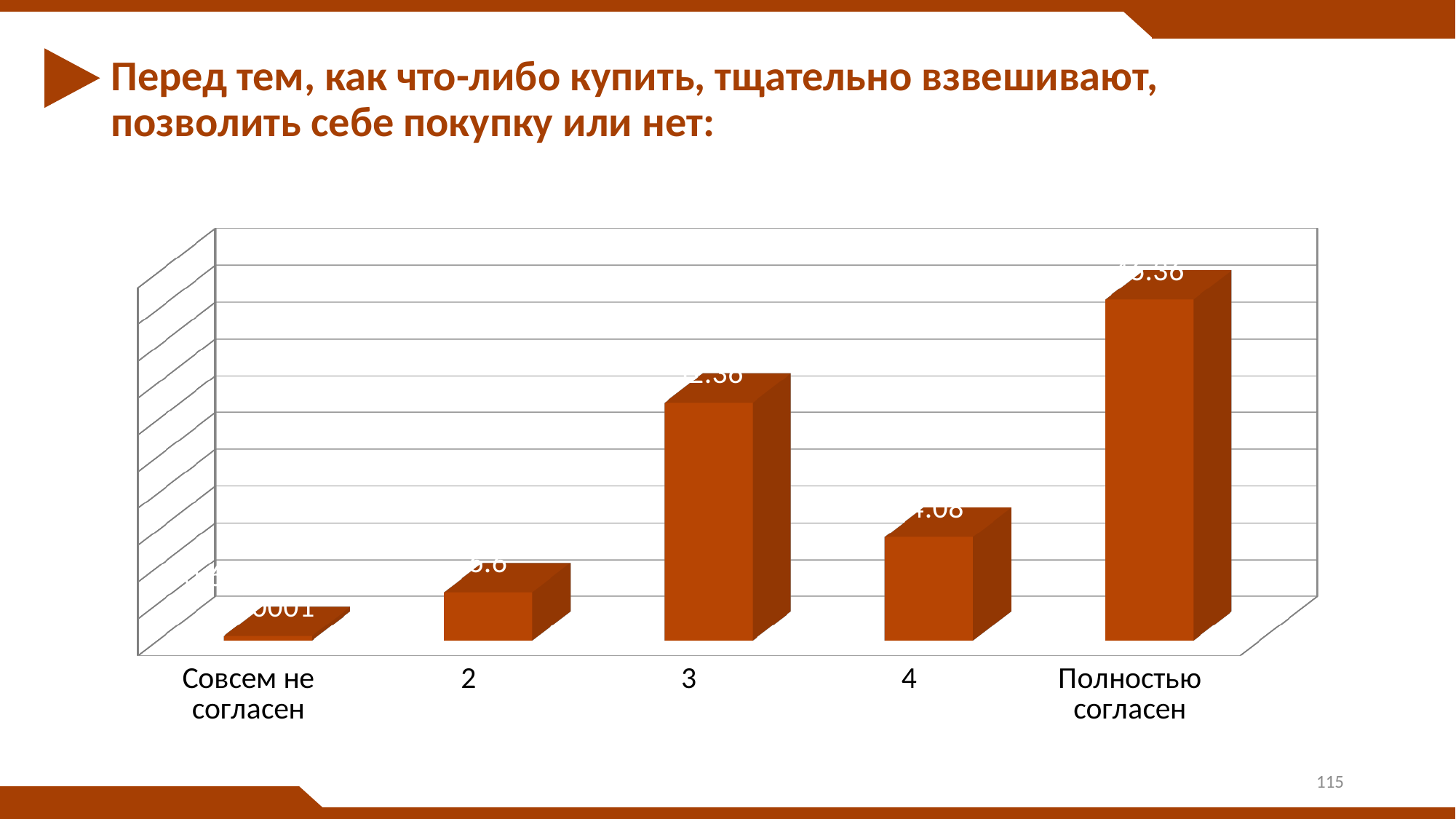
What kind of chart is shown on the slide? Bar chart What is the title of the slide containing the chart? Перед тем, как что-либо купить, тщательно взвешивают, позволить себе покупку или нет: Which has the larger value, 'Совсем не согласен' or category 2? 2 Which category has the highest bar in the chart? Полностью согласен Which has the larger value, category 3 or category 4? 3 Which has the larger value, category 2 or category 4? 4 Do the bar values rise steadily from left to right across the x axis? No Which category has the lowest bar in the chart? Совсем не согласен What is the label of the first category on the x axis? Совсем не согласен How many categories are shown on the x axis of the chart? 5